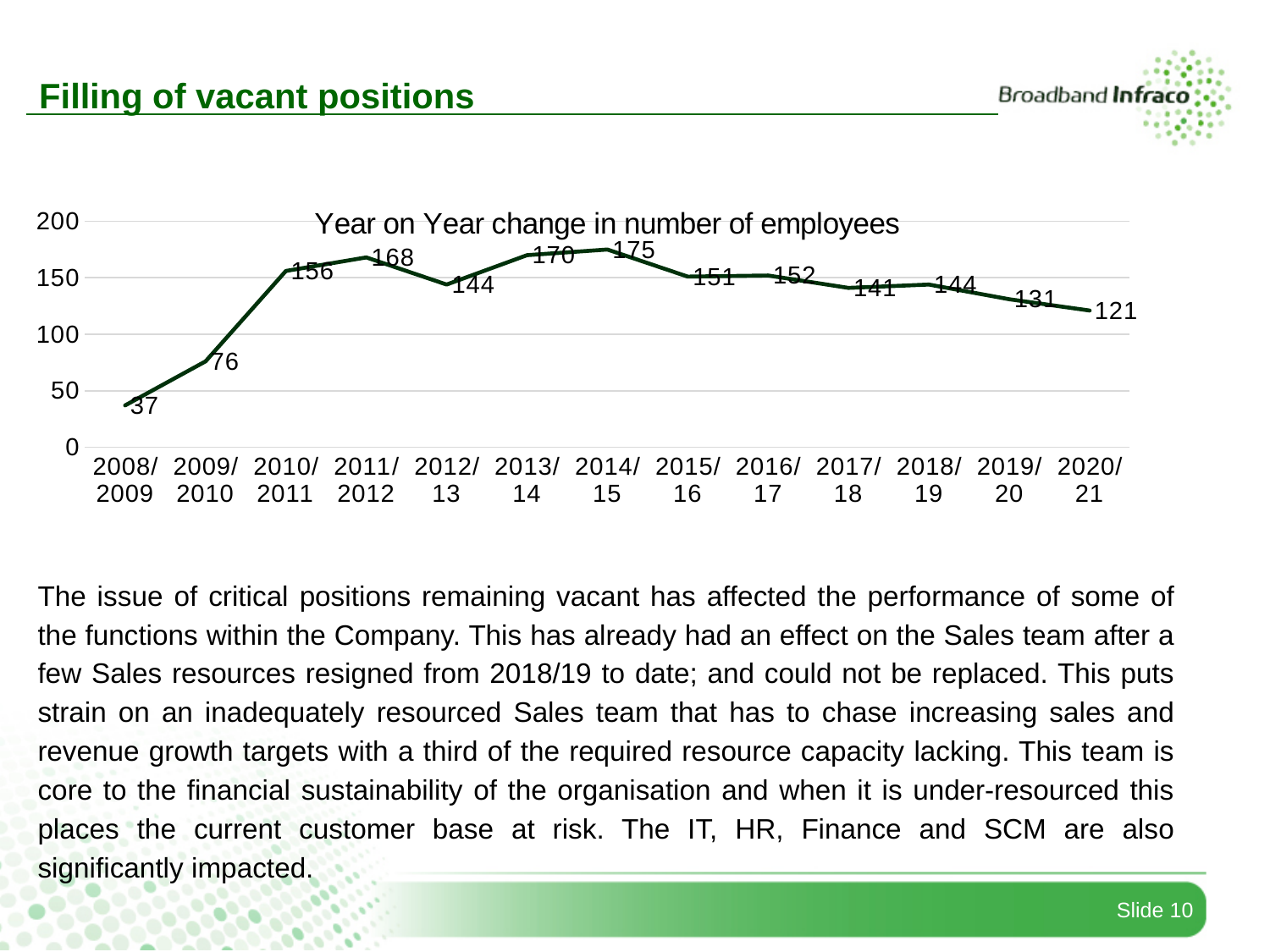
Which period has the lowest number of employees? 2008/2009 How many periods are plotted on the x axis? 13 What is the difference between the number of employees in 2014/15 and 2020/21? 54 Do the values rise or fall from 2014/15 to 2020/21? fall What is the title of the chart? Year on Year change in number of employees Which is larger, the value for 2011/2012 or the value for 2012/13? 2011/2012 Is the value for 2009/2010 greater or less than 100? less What type of chart is shown on the slide? Line chart What is the number of employees for 2008/2009? 37 Which period has the highest number of employees? 2014/15 What is the number of employees for 2014/15? 175 What is the number of employees for 2020/21? 121